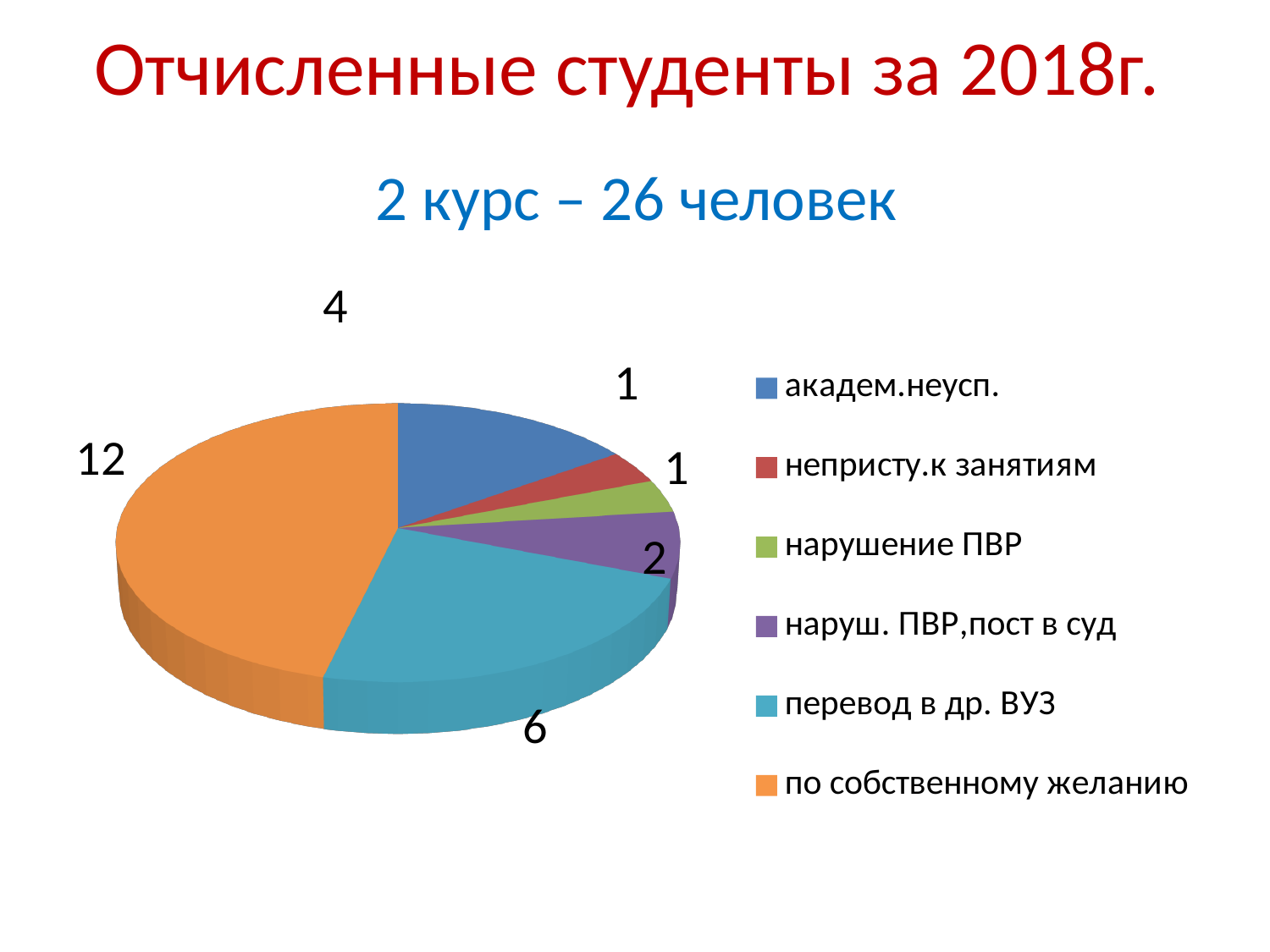
Which is larger, the value for 'академ.неусп.' or the value for 'наруш. ПВР,пост в суд'? академ.неусп. Which category has the largest slice? по собственному желанию What share of the pie does 'по собственному желанию' represent, given the total of 26? 12/26 What type of chart is shown on the slide? pie chart What is the difference between the values for 'по собственному желанию' and 'перевод в др. ВУЗ'? 6 What is the value for 'академ.неусп.'? 4 What is the value for 'по собственному желанию'? 12 What is the value for 'наруш. ПВР,пост в суд'? 2 How many slices does the pie chart have? 6 What is the title of the slide above the chart? Отчисленные студенты за 2018г. What is the value for 'перевод в др. ВУЗ'? 6 How many entries does the legend list? 6